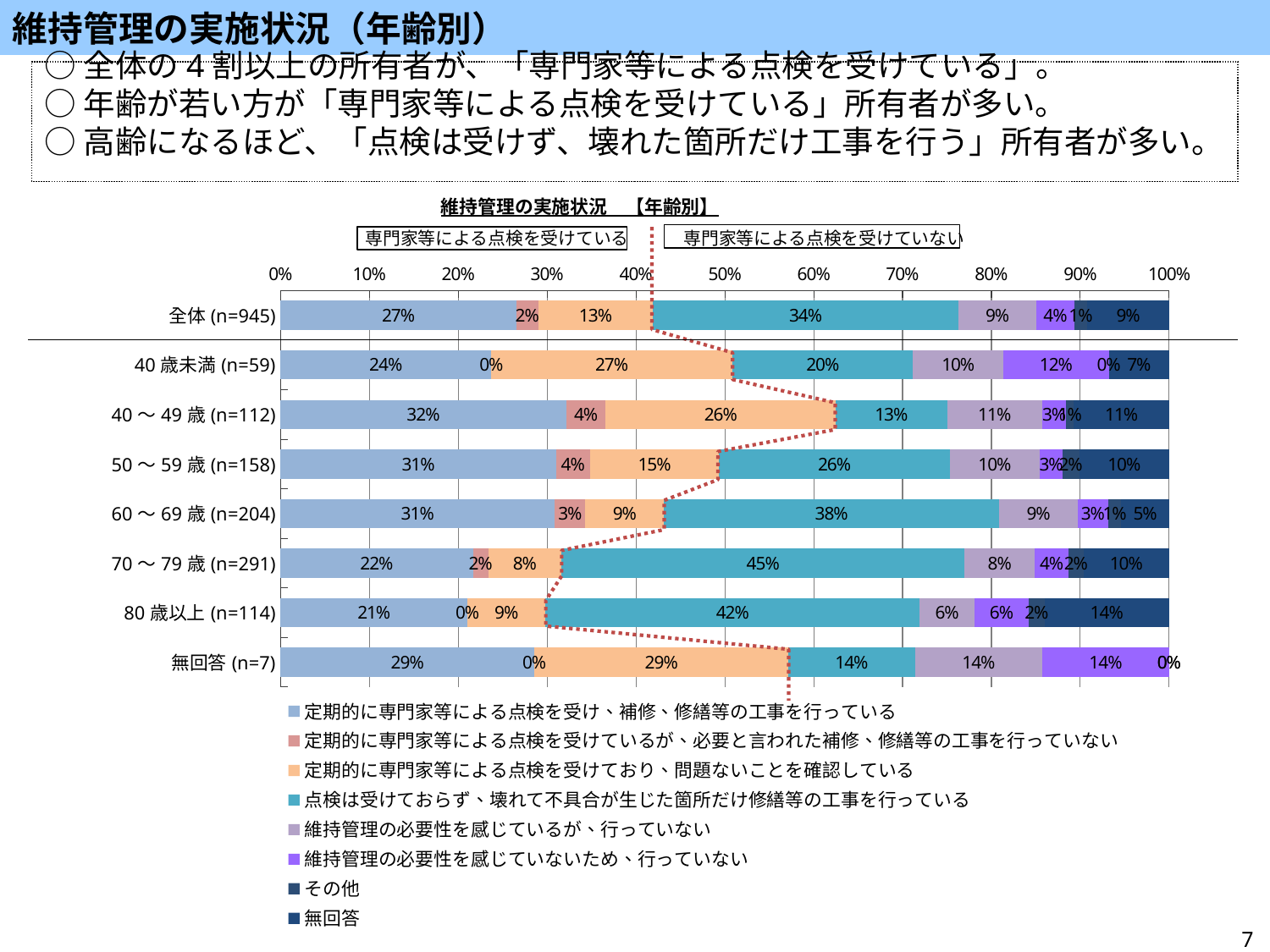
What is the value of 「無回答」 for 80歳以上 (n=114)? 14% Which age category has the highest value for 「点検は受けておらず、壊れて不具合が生じた箇所だけ修繕等の工事を行っている」? 70〜79歳 (n=291) What is the value of 「点検は受けておらず、壊れて不具合が生じた箇所だけ修繕等の工事を行っている」 for 70〜79歳 (n=291)? 45% How many categories (rows) are plotted in the chart? 8 What is the value of 「定期的に専門家等による点検を受けており、問題ないことを確認している」 for 40〜49歳 (n=112)? 26% What kind of chart is shown on the slide? Stacked bar chart Which is larger for 「定期的に専門家等による点検を受け、補修、修繕等の工事を行っている」: 40〜49歳 (n=112) or 70〜79歳 (n=291)? 40〜49歳 (n=112) What is the title of the chart? 維持管理の実施状況 【年齢別】 For 全体 (n=945), what is the difference between 「点検は受けておらず、壊れて不具合が生じた箇所だけ修繕等の工事を行っている」 (34%) and 「定期的に専門家等による点検を受け、補修、修繕等の工事を行っている」 (27%)? 7 percentage points How many series does the legend list? 8 What is the value of 「定期的に専門家等による点検を受け、補修、修繕等の工事を行っている」 for 全体 (n=945)? 27% Which category has the lowest value for 「定期的に専門家等による点検を受け、補修、修繕等の工事を行っている」? 80歳以上 (n=114)